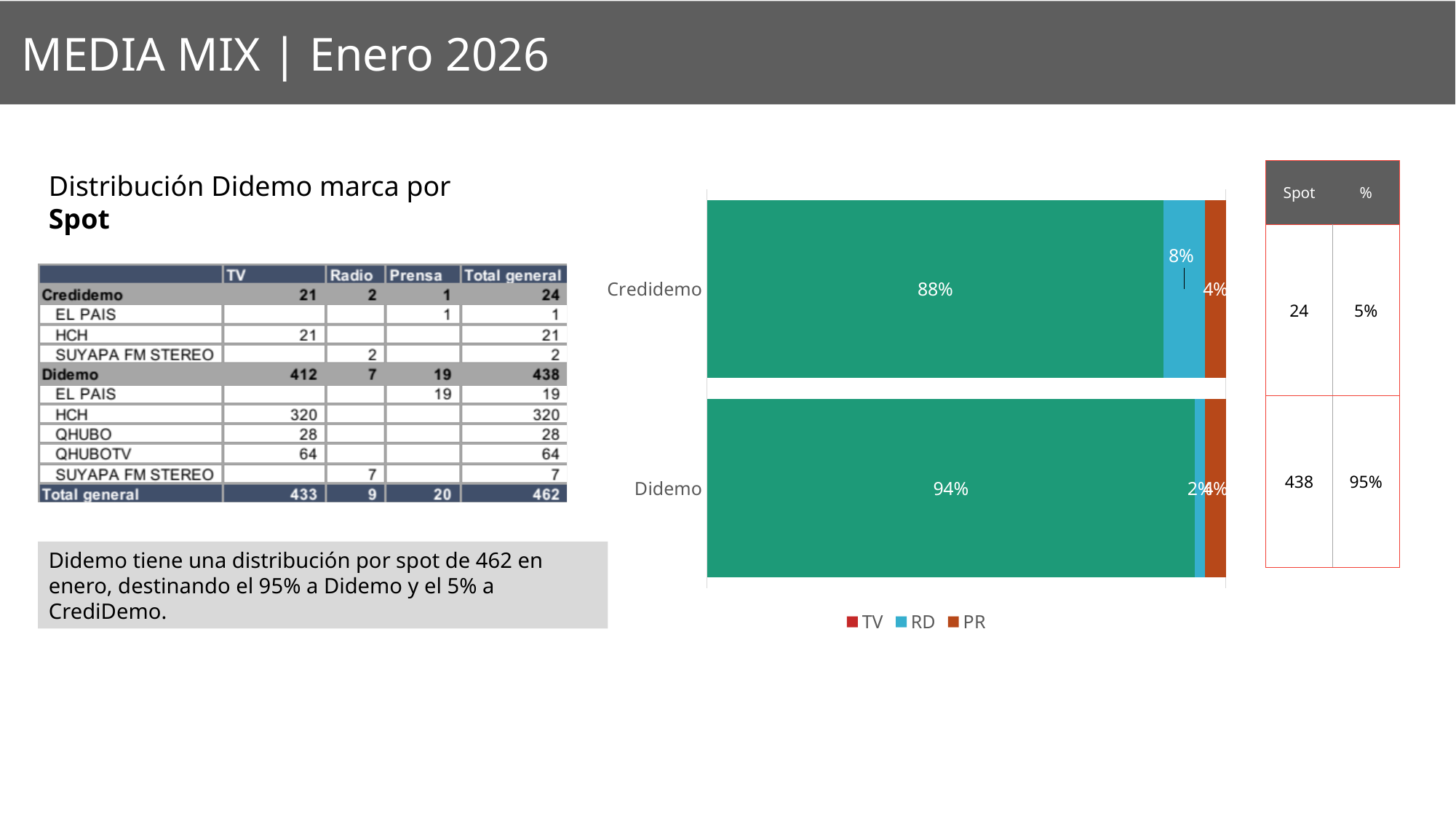
What type of chart is shown on the slide? stacked bar chart Which category has the higher TV share, Credidemo or Didemo? Didemo What is the PR share for Didemo in the bar chart? 4% What is the RD share for Credidemo in the bar chart? 8% Which category has the lowest RD share? Didemo What is the TV share for Credidemo in the bar chart? 88% What are the series names listed in the chart legend? TV, RD, PR What is the TV share for Didemo in the bar chart? 94% How many series does the chart legend list? 3 What is the difference between the RD share for Credidemo and the RD share for Didemo? 6% What is the RD share for Didemo in the bar chart? 2% How many categories are plotted in the bar chart? 2